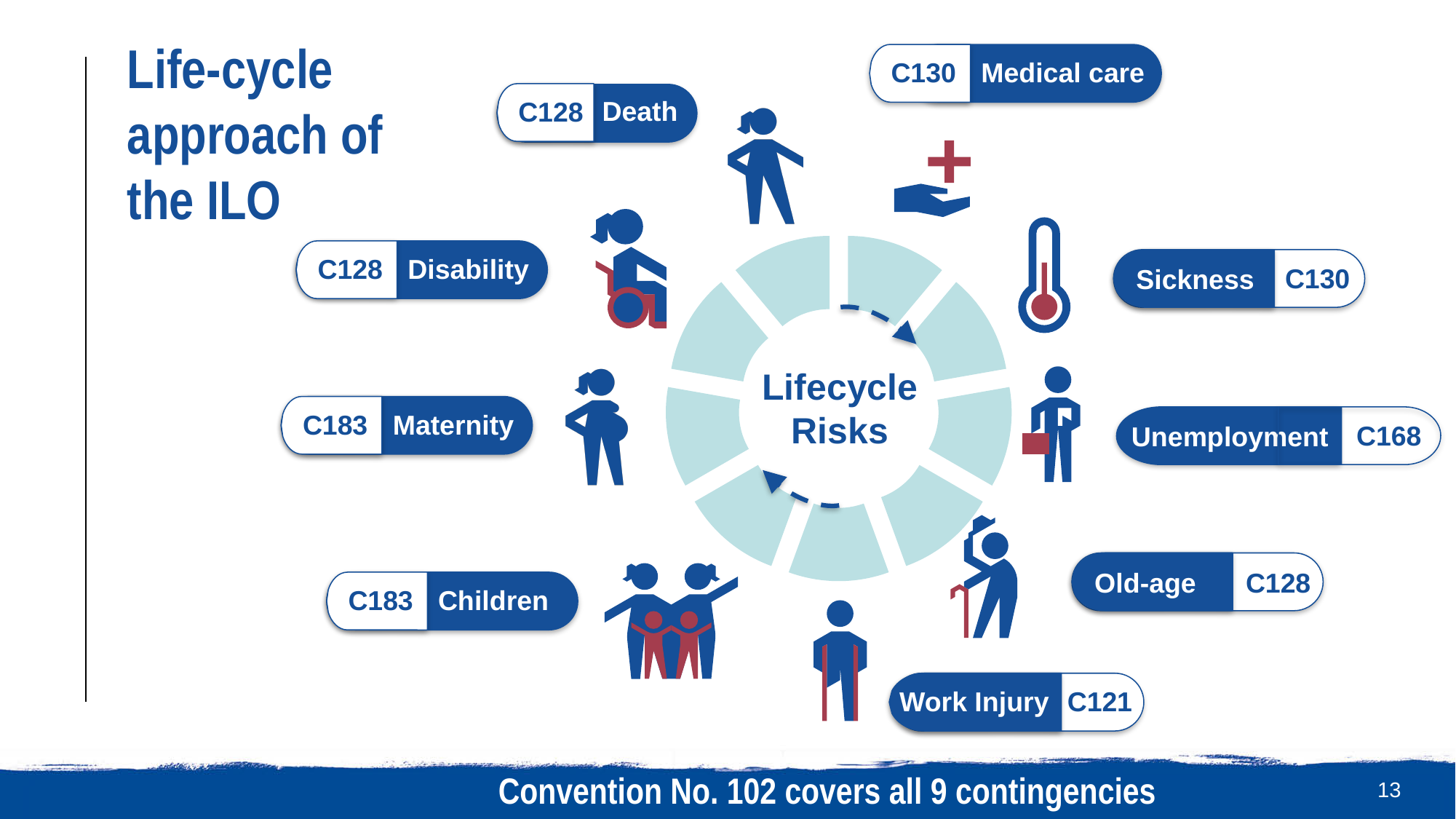
What text appears in the centre of the circular diagram? Lifecycle Risks How many contingencies does the slide say Convention No. 102 covers? 9 Which convention number is shown next to Maternity in the diagram? C183 Which convention number is shown next to Unemployment in the diagram? C168 What kind of chart is shown on the slide? A doughnut chart Which convention number is shown next to Sickness in the diagram? C130 How many segments does the circular "Lifecycle Risks" diagram have? 9 Which convention number is shown next to Old-age in the diagram? C128 Which convention number is shown next to Work Injury in the diagram? C121